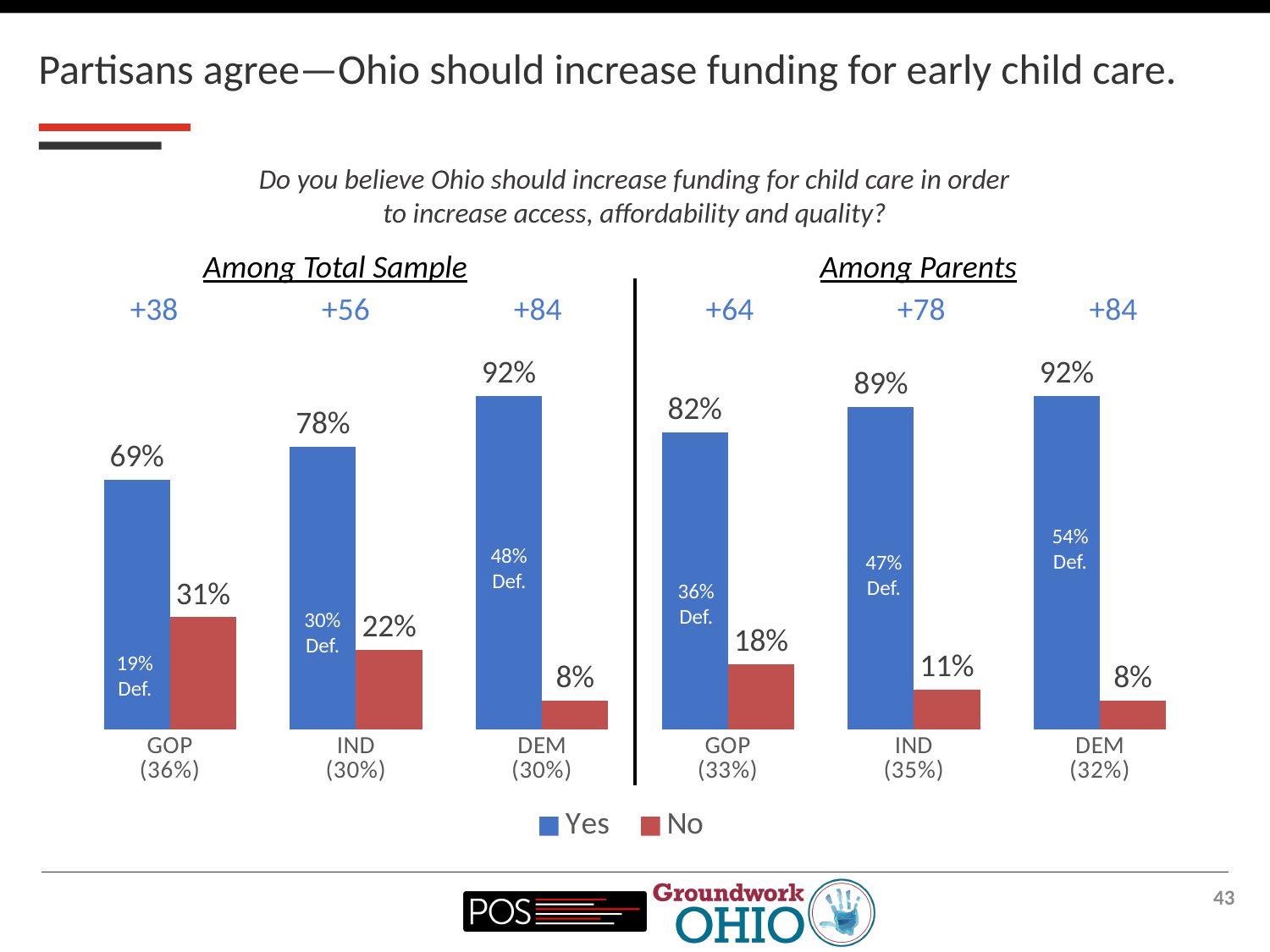
Which colour represents the No series in the legend? red In the Among Total Sample chart, do the Yes values rise or fall moving from GOP to DEM? rise In the Among Parents chart, what percentage of IND respondents answered No? 11% How many party groups are shown in the Among Parents chart? 3 In the Among Total Sample chart, what is the difference between the Yes and No values for IND? 56 How many series does the legend list? 2 In the Among Parents chart, which party group has the lowest No value? DEM In the Among Parents chart, what is the net margin shown above the DEM bars? +84 What kind of chart is the Among Total Sample chart? bar chart In the Among Total Sample chart, which party group has the highest Yes value? DEM In the Among Parents chart, is the Yes value for GOP larger or smaller than the Yes value for IND? smaller In the Among Total Sample chart, what percentage of GOP respondents answered Yes? 69%